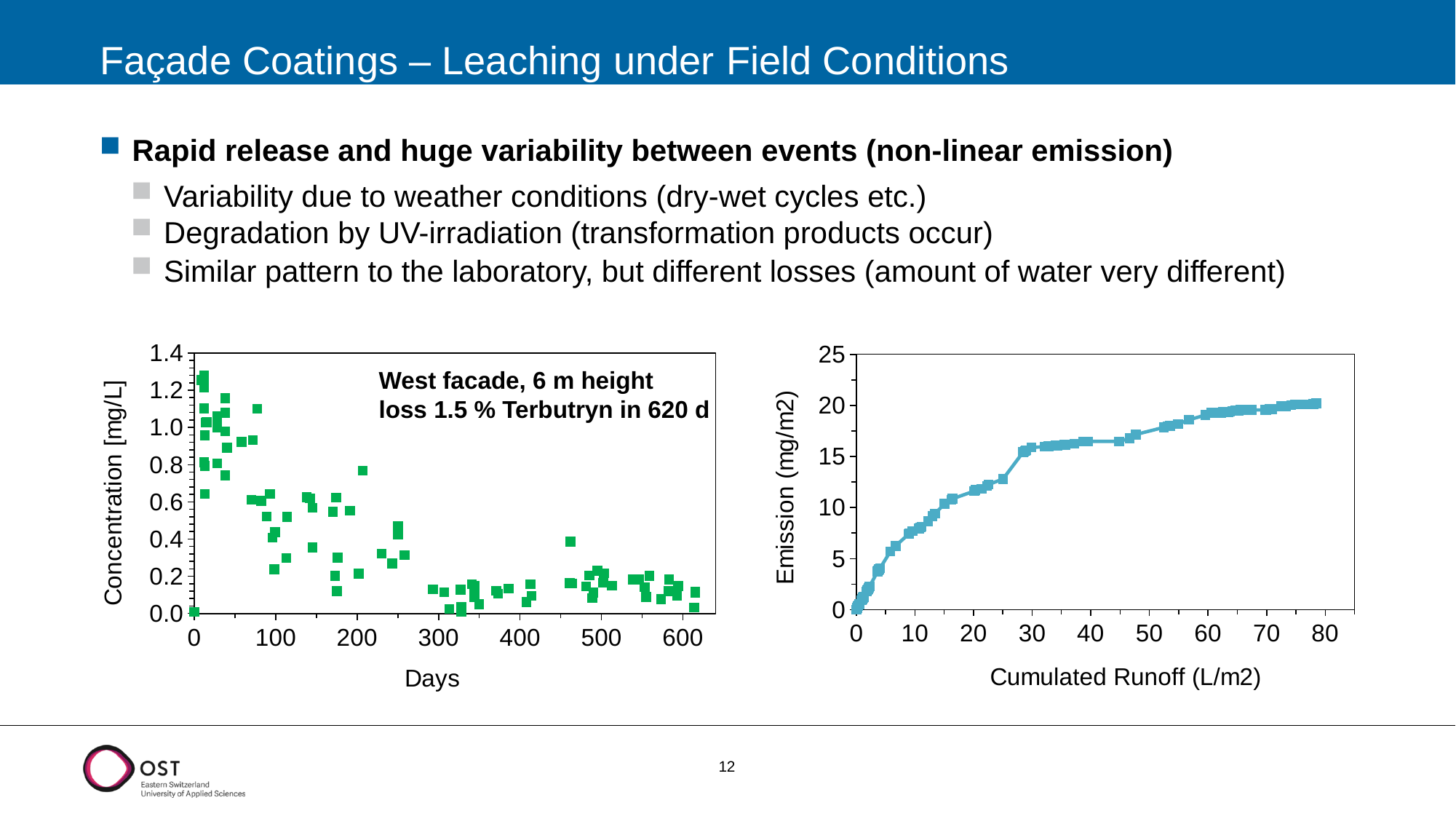
In the left chart, is the highest concentration value (near day 0) greater or less than 1.2 mg/L? greater What is the y-axis label of the left chart? Concentration [mg/L] In the right chart, is the emission at a cumulated runoff of about 80 L/m2 greater or less than 15 mg/m2? greater In the left chart, is the concentration at around day 460 (the isolated higher point) greater or less than 0.2 mg/L? greater In the right chart, does the emission rise or fall as cumulated runoff increases? rise In the left chart, do the concentration values generally rise or fall as the days increase? fall What kind of chart is the left chart (Concentration vs Days)? scatter plot What is the x-axis label of the right chart? Cumulated Runoff (L/m2) What is the maximum value shown on the y-axis of the right chart? 25